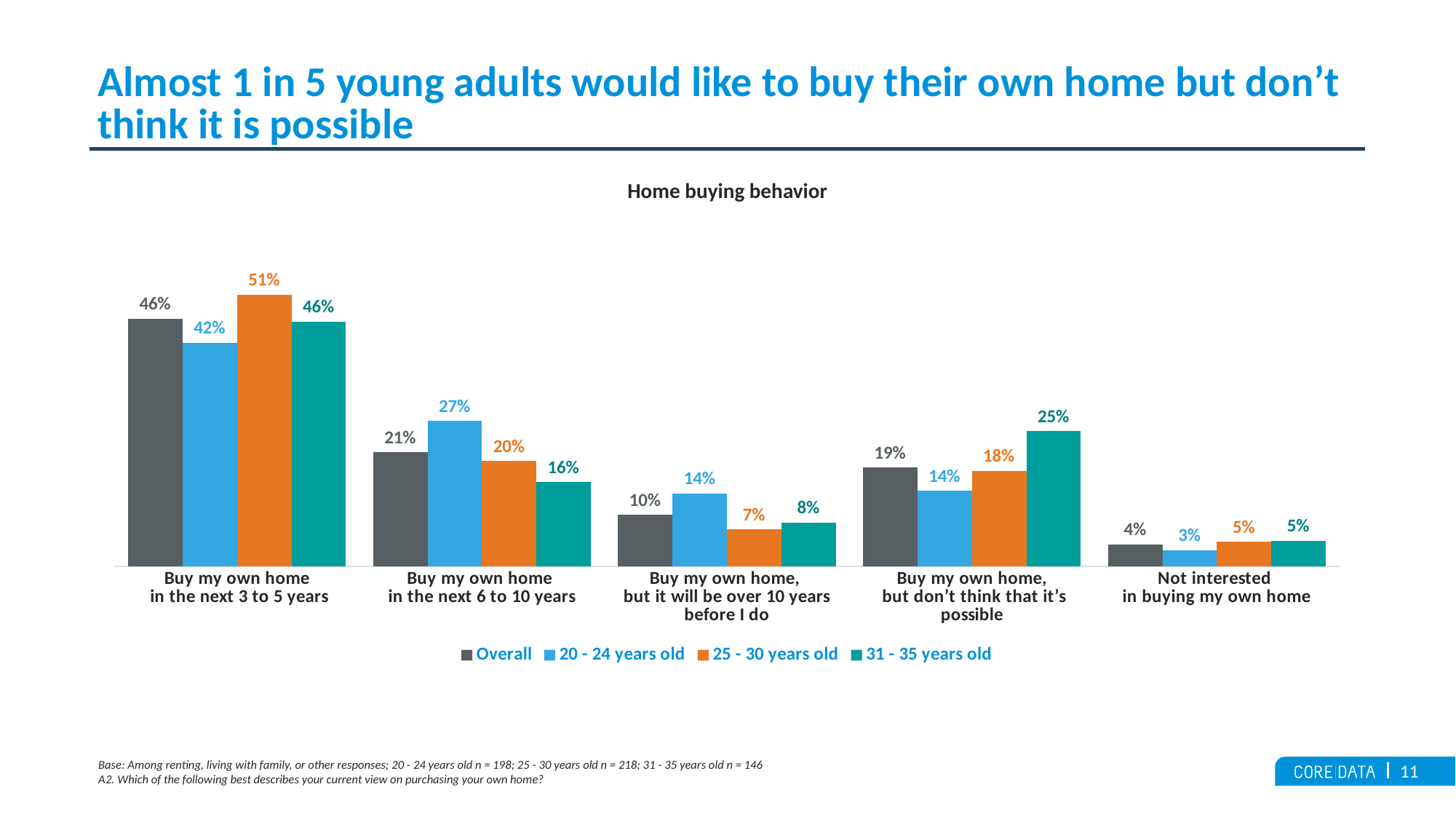
Which category has the lowest Overall value? Not interested in buying my own home For "Buy my own home, but it will be over 10 years before I do", which is larger: the value for 20 - 24 years old or 31 - 35 years old? 20 - 24 years old Which colour represents the 25 - 30 years old series? Orange What is the difference between the 25 - 30 years old and 20 - 24 years old values for "Buy my own home in the next 3 to 5 years"? 9% What is the Overall value for "Buy my own home in the next 3 to 5 years"? 46% What is the value for 31 - 35 years old for "Buy my own home, but don't think that it's possible"? 25% What kind of chart is shown on the slide? Bar chart What is the title of the chart? Home buying behavior What is the value for 20 - 24 years old for "Buy my own home in the next 6 to 10 years"? 27% Which category has the highest value for 25 - 30 years old? Buy my own home in the next 3 to 5 years How many series does the legend list? 4 How many categories are shown on the x axis? 5